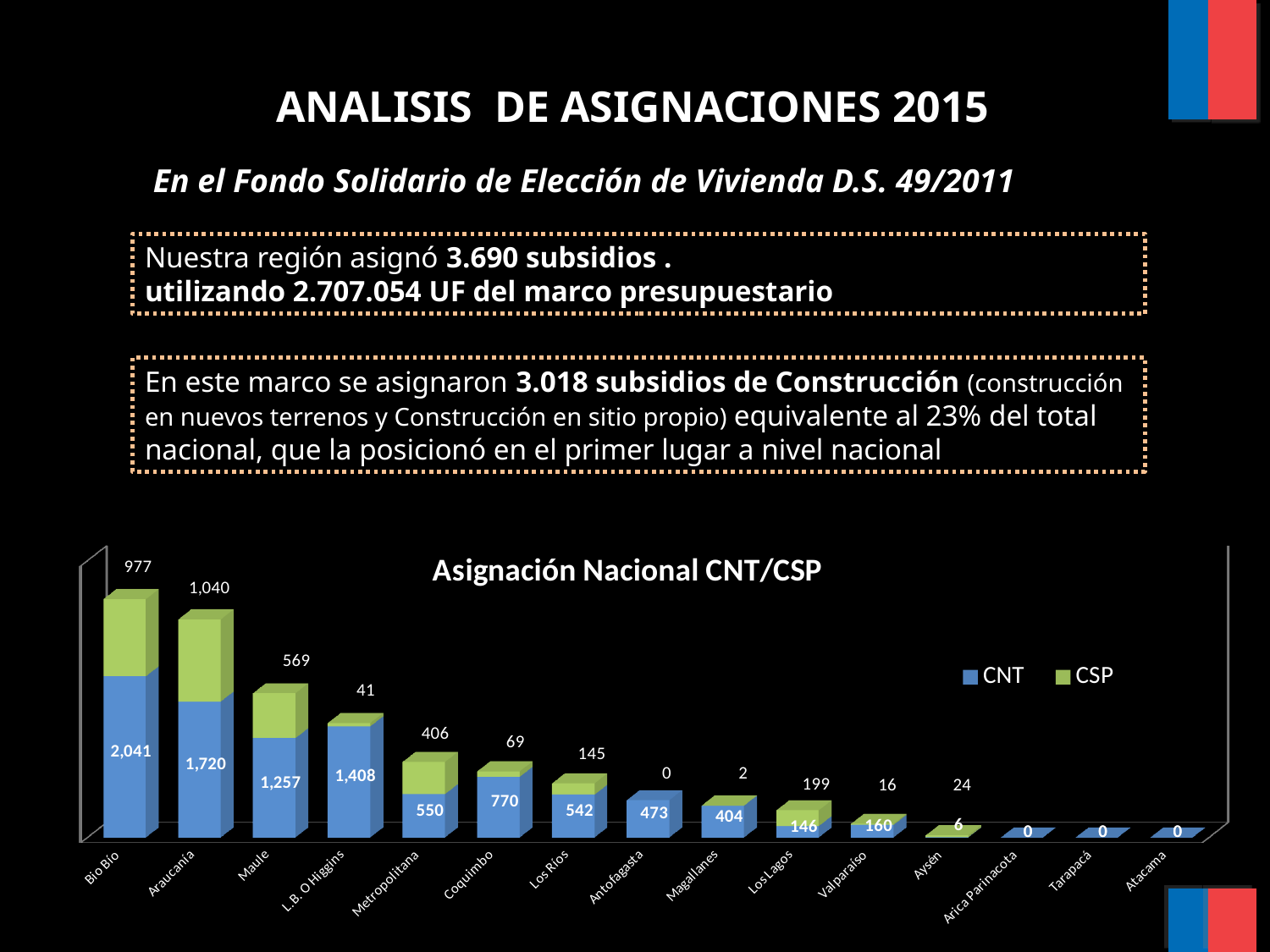
What is the title of the chart? Asignación Nacional CNT/CSP What is the CNT value for L.B. O'Higgins? 1,408 Which region has the highest CNT value? Bio Bío Which is larger, the CNT value for Coquimbo or the CNT value for Metropolitana? Coquimbo What type of chart is shown on the slide? stacked bar chart Which region has the highest CSP value? Araucanía What is the difference between the CNT values of Bio Bío and Araucanía? 321 How many regions (categories) are shown on the x axis of the chart? 15 What is the total of the stacked bar for Bio Bío (CNT plus CSP)? 3,018 How many series does the chart legend list? 2 What is the CSP value for Araucanía? 1,040 What is the CNT value for Bio Bío? 2,041